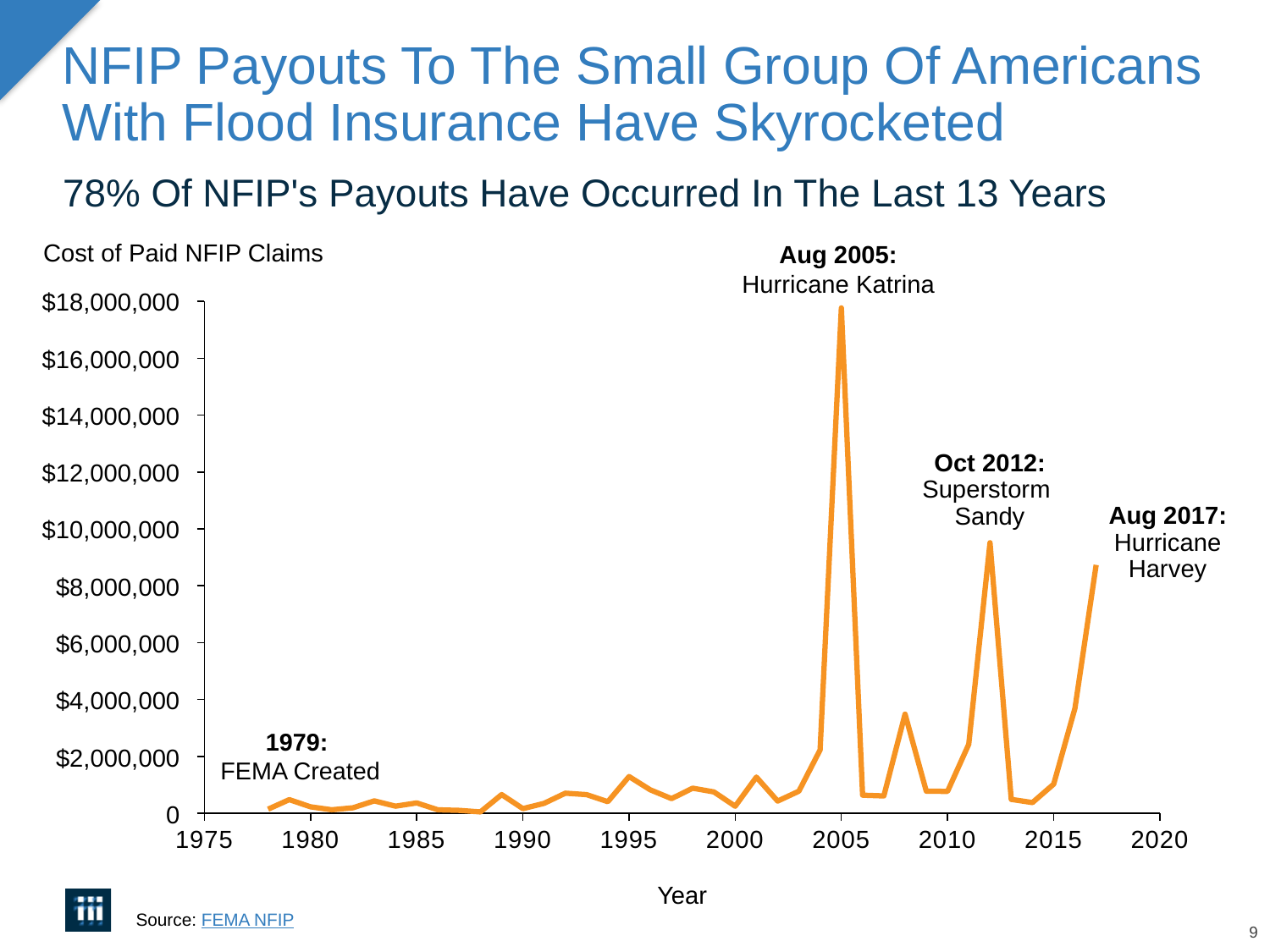
Which year had a higher Cost of Paid NFIP Claims, 2008 or 2012? 2012 Is the Cost of Paid NFIP Claims in 2008 greater or less than $4,000,000? less Is the Cost of Paid NFIP Claims in 2012 greater or less than $10,000,000? less Which year had a higher Cost of Paid NFIP Claims, 2005 or 2012? 2005 Do the Cost of Paid NFIP Claims values rise or fall from 2014 to 2017? rise What kind of chart is shown on the slide? Line chart What is the title of the chart? Cost of Paid NFIP Claims Is the Cost of Paid NFIP Claims in 2005 greater or less than $16,000,000? greater In which year does the Cost of Paid NFIP Claims reach its highest value? 2005 Which event is annotated at the chart's 2005 peak? Hurricane Katrina